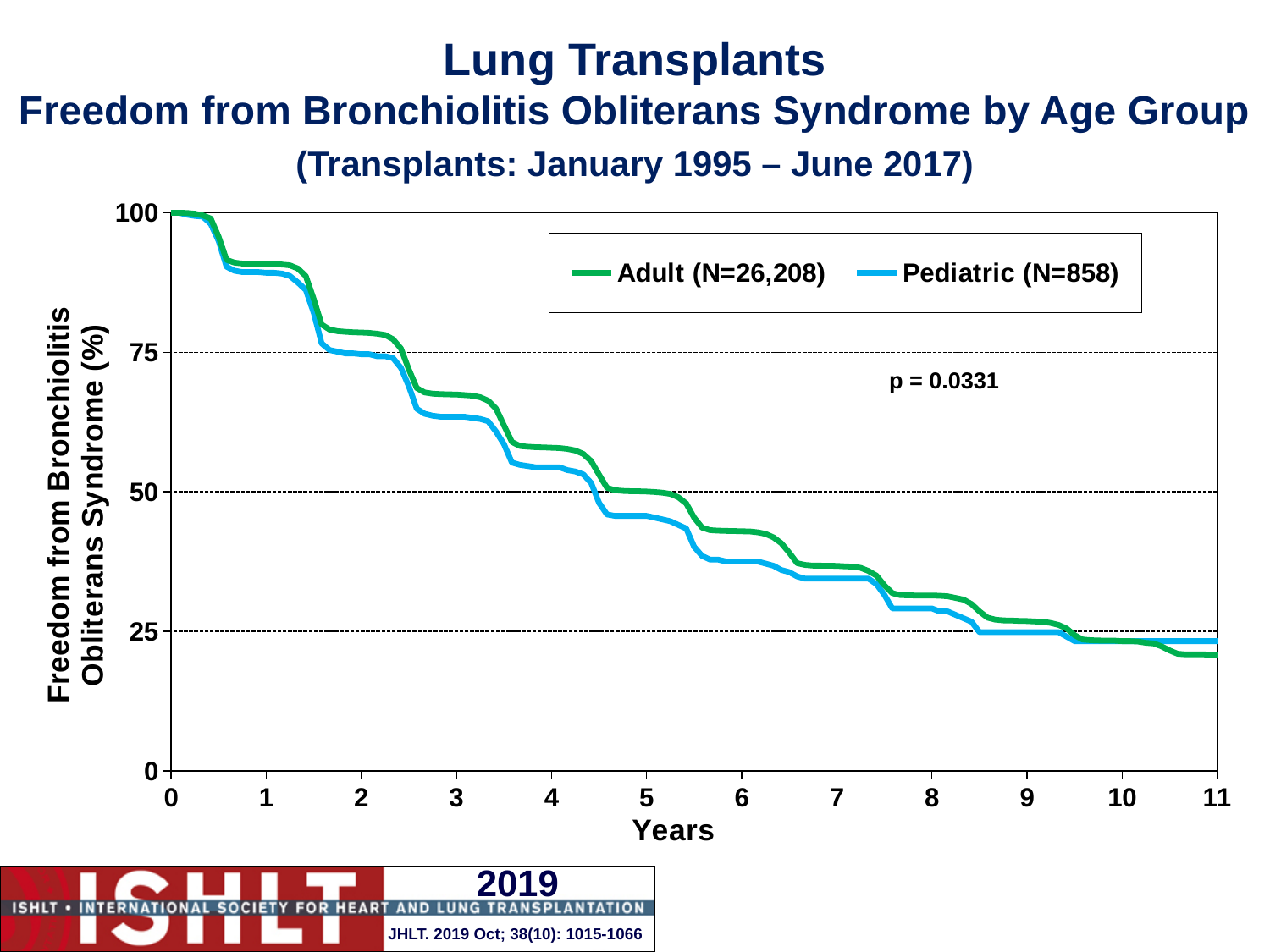
Do the values for the Adult series rise or fall as years increase? fall What is the maximum value shown on the x axis (Years)? 11 At year 5, which series has the higher freedom from bronchiolitis obliterans syndrome, Adult or Pediatric? Adult Is the value for the Pediatric series at year 5 greater or less than 50? less Is the value for the Adult series at year 4 greater or less than 50? greater Is the value for the Adult series at year 11 greater or less than 25? less What p-value is printed on the chart? p = 0.0331 Which two series are shown in the legend? Adult (N=26,208) and Pediatric (N=858) How many series does the legend list? 2 What kind of chart is shown on the slide? line chart